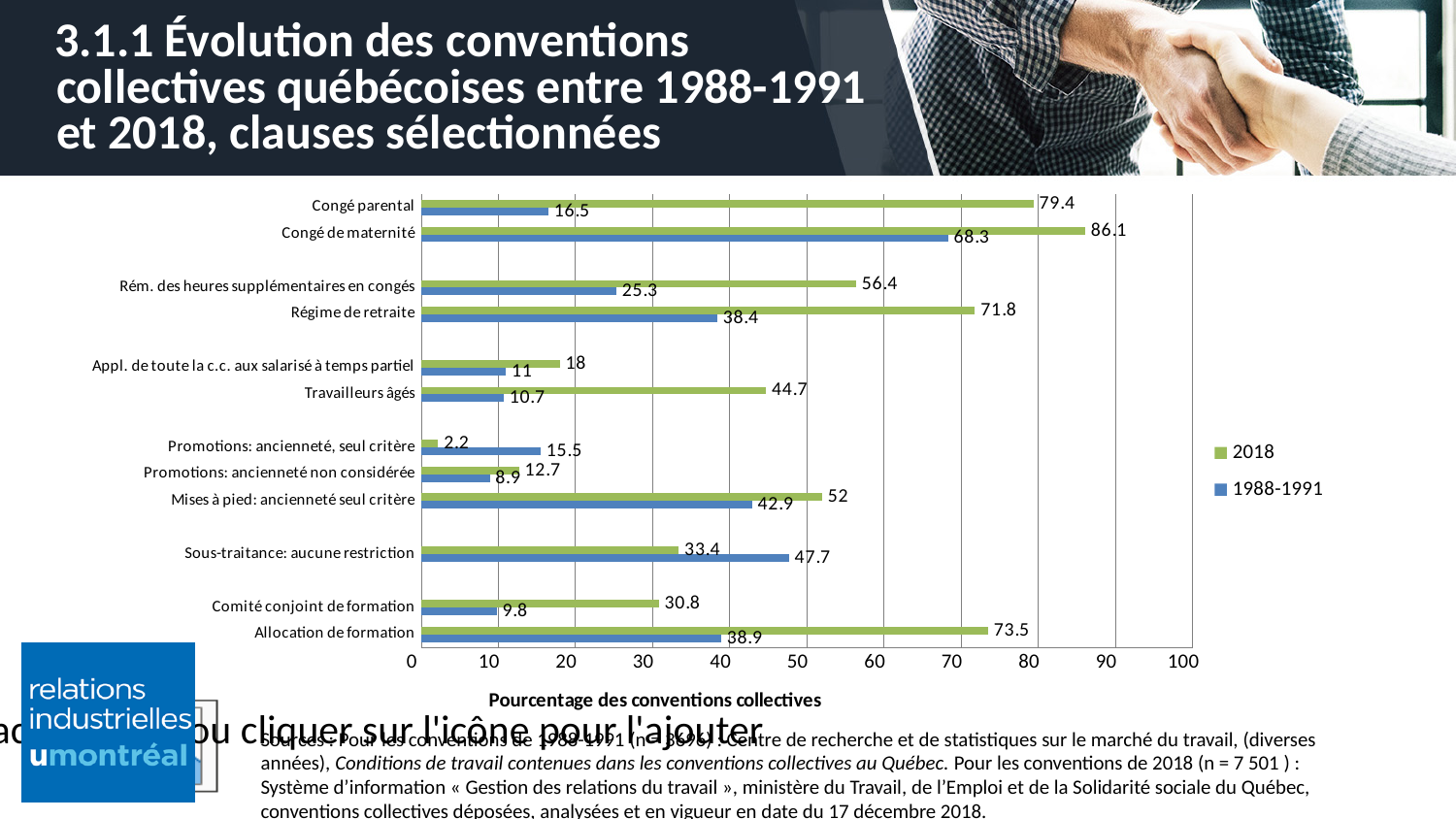
How many categories are plotted on the chart? 12 Is the 2018 value for Allocation de formation greater or less than 70? greater What is the difference between the 2018 and 1988-1991 values for Régime de retraite? 33.4 What is the 2018 value for Travailleurs âgés? 44.7 How many series does the legend list? 2 Which category has the highest 2018 value? Congé de maternité Which category has the lowest 2018 value? Promotions: ancienneté, seul critère For Sous-traitance: aucune restriction, which series has the larger value, 2018 or 1988-1991? 1988-1991 What is the 2018 value for Congé de maternité? 86.1 What is the label of the x axis? Pourcentage des conventions collectives What is the 1988-1991 value for Congé parental? 16.5 What type of chart is shown on the slide? bar chart